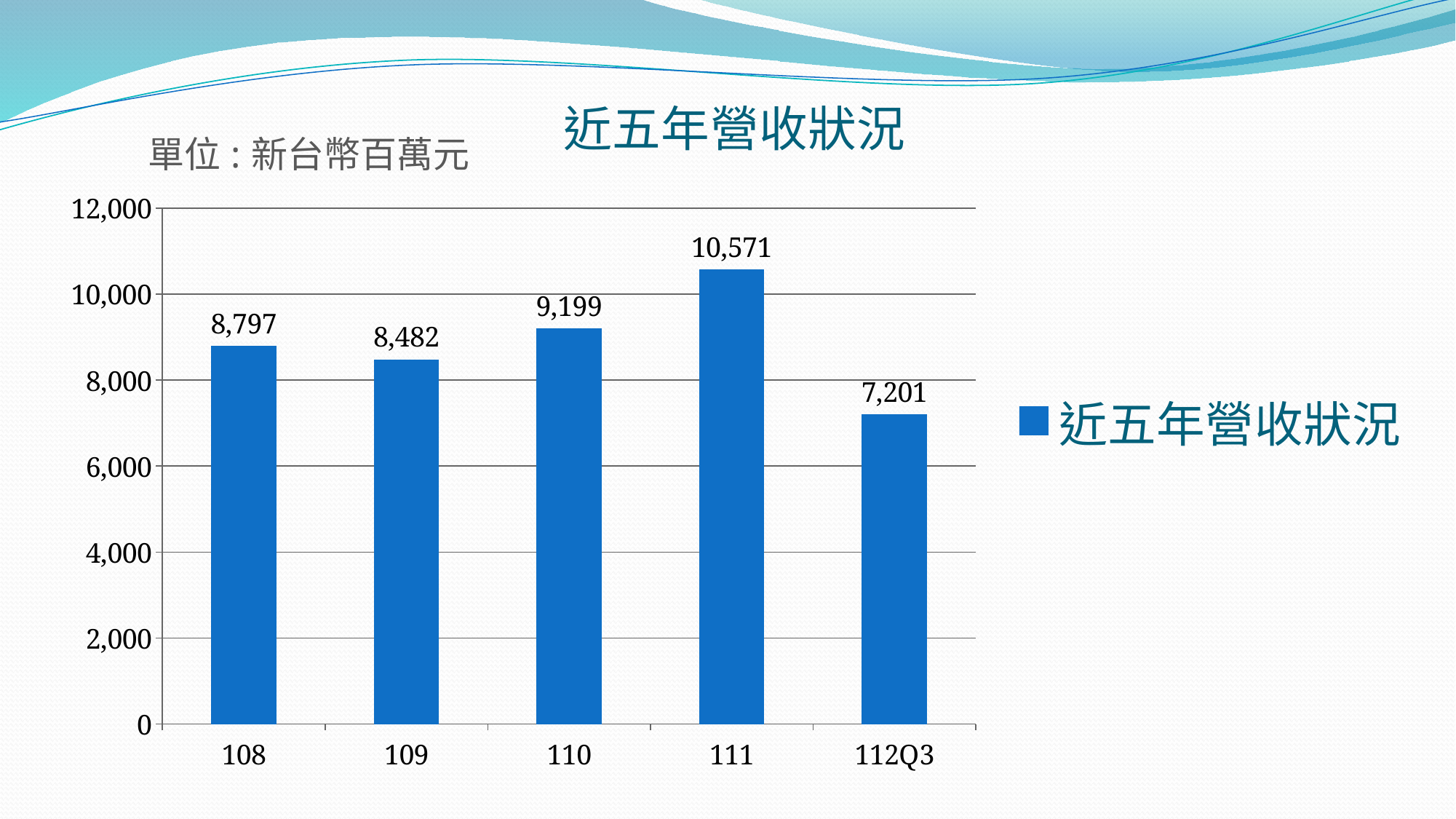
Is the value for 110 greater or less than 8,000? greater What is the value for 112Q3? 7,201 What is the value for 108? 8,797 What kind of chart is shown? bar chart Which category has the lowest value? 112Q3 What is the title of the chart? 近五年營收狀況 Which is larger, the value for 108 or the value for 109? 108 Which category has the highest value? 111 What is the value for 111? 10,571 How many series does the legend list? 1 What is the difference between the values for 111 and 110? 1,372 How many categories are shown on the x axis? 5